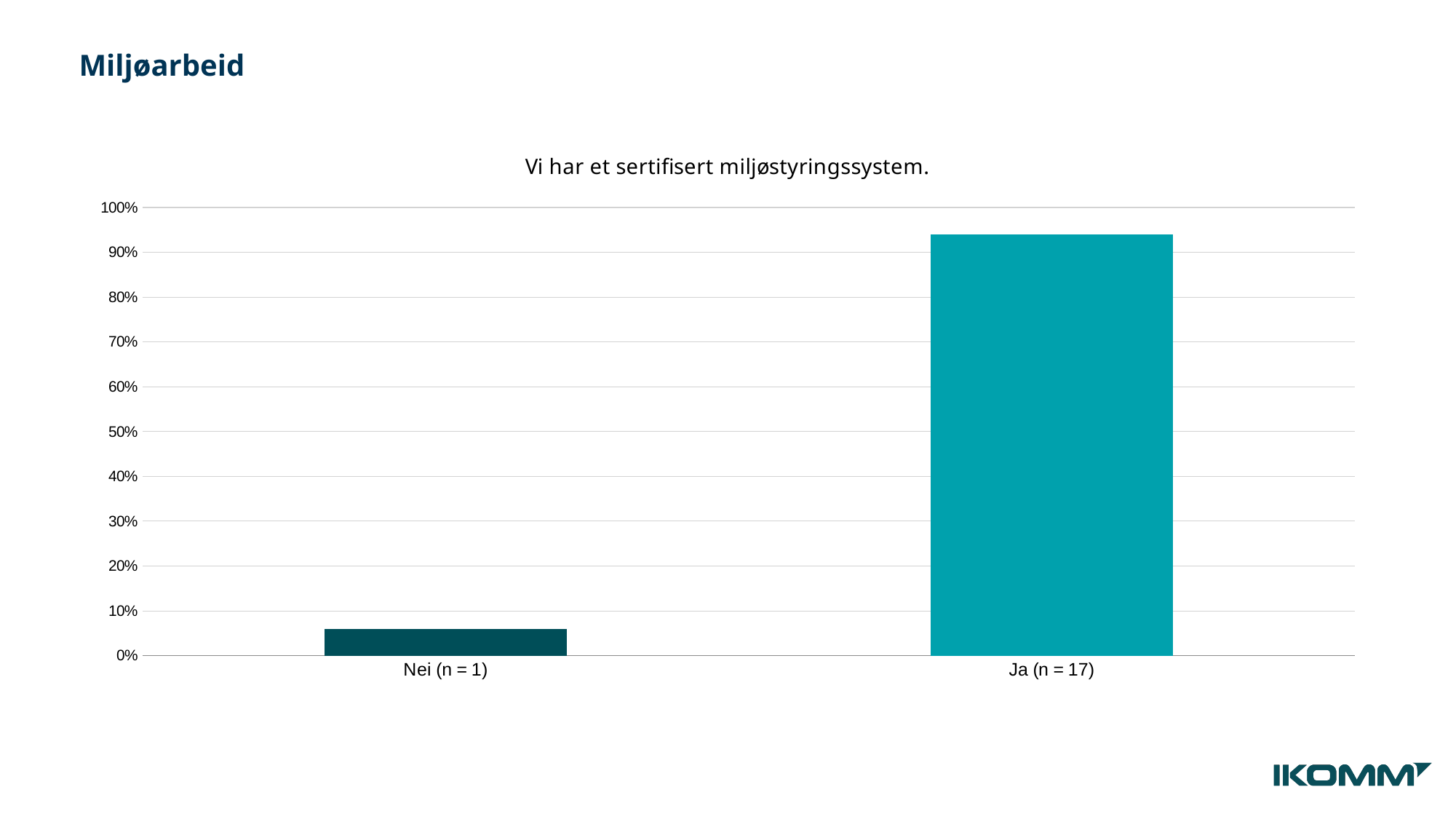
How many categories are plotted in the chart? 2 Is the value for Nei (n = 1) greater or less than 10%? less Do the values rise or fall from left to right along the x axis? Rise Is the value for Ja (n = 17) greater or less than 50%? greater Which category has the highest value? Ja (n = 17) What kind of chart is shown on the slide? Bar chart What is the title of the chart? Vi har et sertifisert miljøstyringssystem. Is the value for Ja (n = 17) greater or less than 90%? greater Which category has the lowest value? Nei (n = 1) What is the highest value shown on the y axis? 100% Which is larger, the value for Nei (n = 1) or the value for Ja (n = 17)? Ja (n = 17)